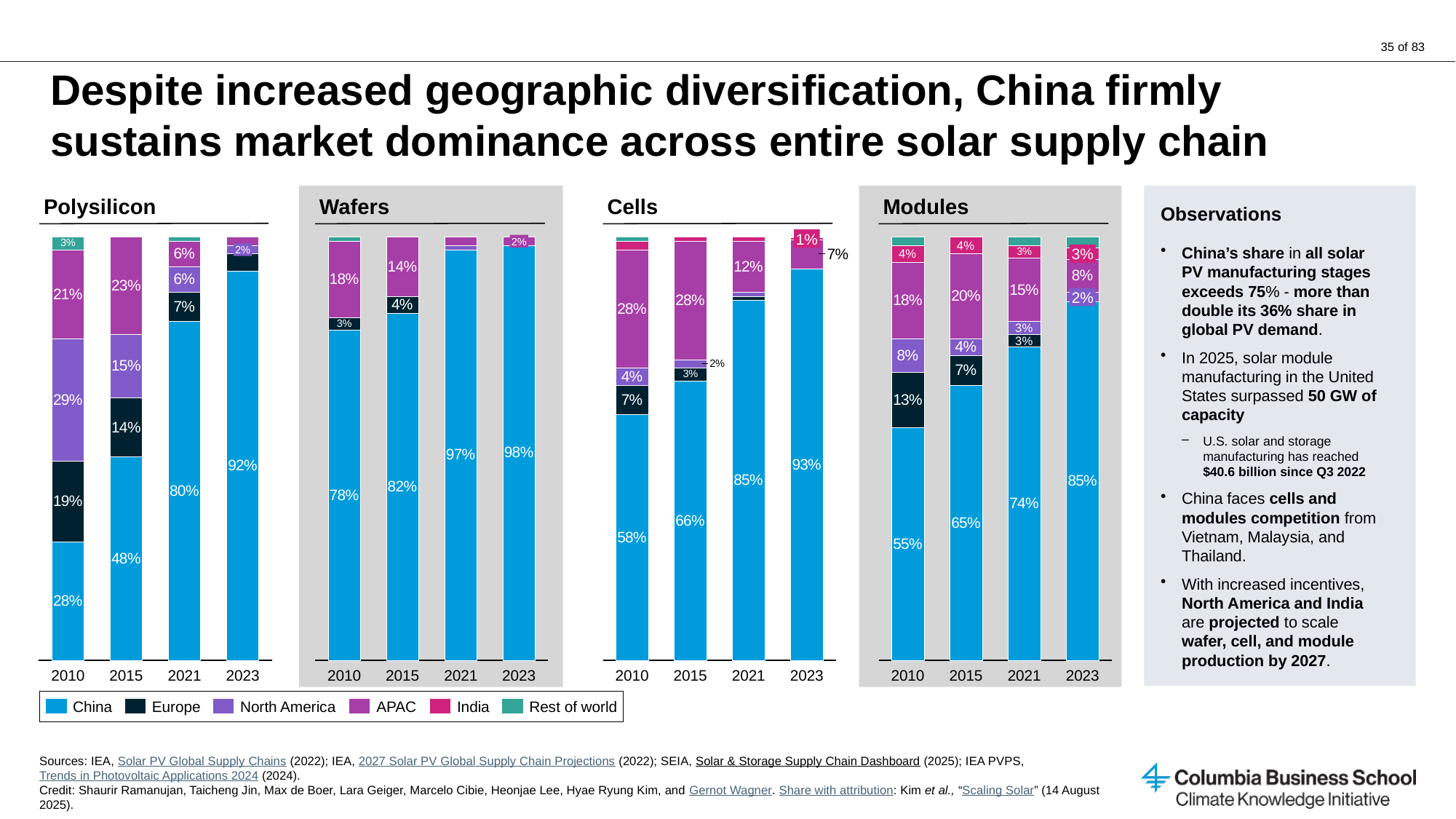
In the Wafers chart, what is China's share in 2023? 98% In the Wafers chart, does China's share rise or fall from 2010 to 2023? Rise In the Modules chart, in which year is China's share highest? 2023 In the Cells chart, in which year is China's share lowest? 2010 In the Cells chart, what is the APAC share in 2015? 28% In the Wafers chart, which is larger: the APAC share in 2010 or in 2015? 2010 In the Modules chart, what is Europe's share in 2010? 13% In the Polysilicon chart, by how many percentage points did China's share increase from 2010 to 2023? 64 percentage points How many years are shown on the x axis of the Modules chart? 4 In the Polysilicon chart, what is China's share in 2010? 28% How many series does the legend list? 6 What kind of chart is the Cells chart? Stacked bar chart